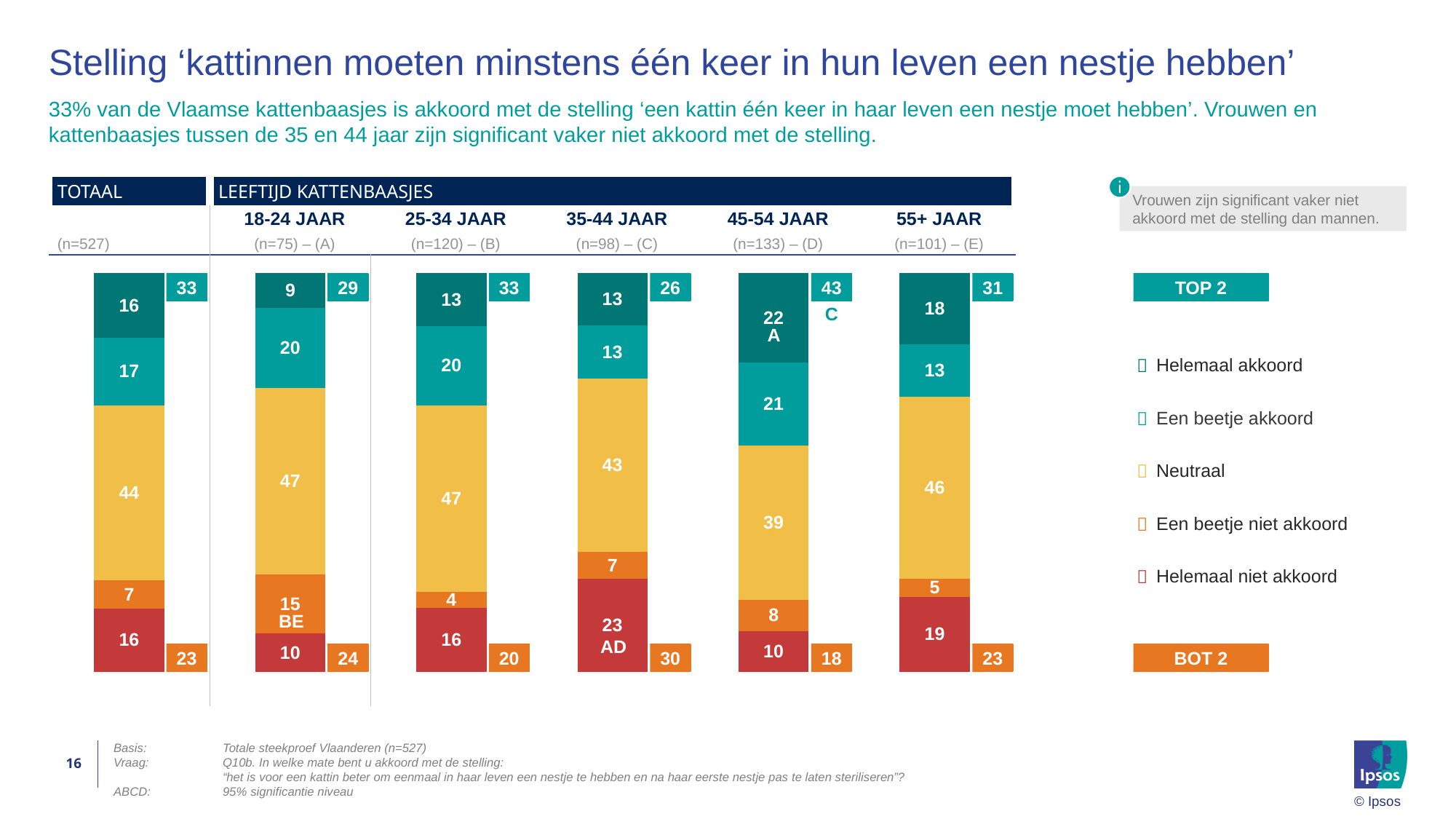
What is the Neutraal value for the TOTAAL bar? 44 What is the Helemaal akkoord value for the 45-54 JAAR group? 22 What kind of chart is shown on the slide? Stacked bar chart Which age group has the lowest BOT 2 value? 45-54 JAAR How many bars (groups) are shown in the chart? 6 How many response categories does the legend list? 5 What is the TOP 2 value for the 35-44 JAAR group? 26 Which age group has the highest TOP 2 value? 45-54 JAAR What is the sample size (n) for the 25-34 JAAR group? n=120 Which is larger: the Een beetje niet akkoord value for 18-24 JAAR or for 25-34 JAAR? 18-24 JAAR What is the difference between the Helemaal niet akkoord values for 35-44 JAAR and 45-54 JAAR? 13 What is the BOT 2 value for the 25-34 JAAR group? 20